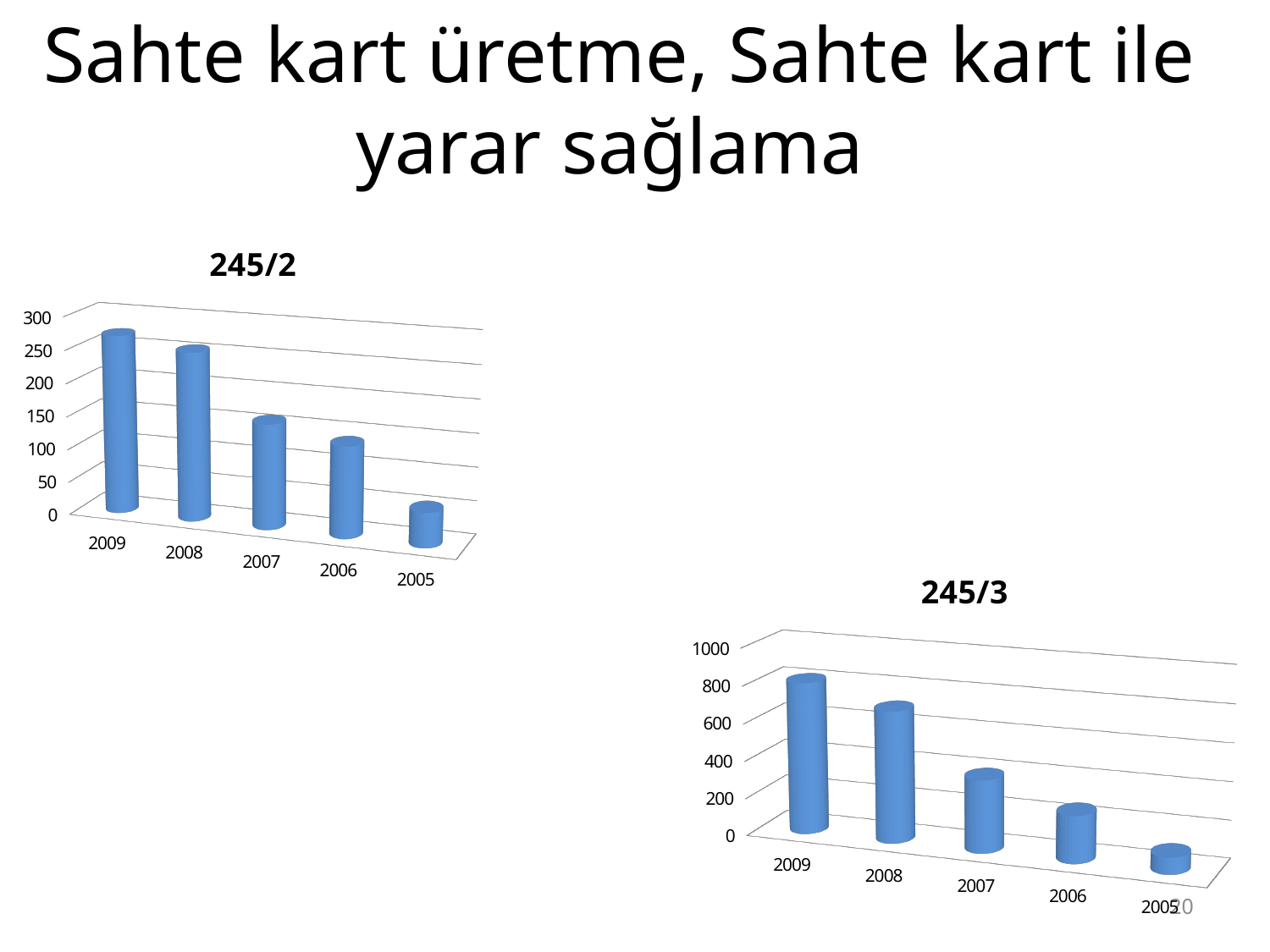
In the chart titled 245/3, which year has the lowest value? 2005 In the chart titled 245/3, is the value for 2009 greater or less than 600? greater How many years are shown on the x axis of the chart titled 245/3? 5 In the chart titled 245/2, which year has the lowest value? 2005 In the chart titled 245/2, do the values rise or fall going from 2009 to 2005 along the x axis? fall In the chart titled 245/2, is the value for 2005 greater or less than 100? less In the chart titled 245/2, which year has the highest value? 2009 In the chart titled 245/3, which year has the highest value? 2009 In the chart titled 245/2, is the value for 2009 greater or less than 200? greater What kind of chart is the chart titled 245/2? bar chart In the chart titled 245/3, which is larger, the value for 2008 or the value for 2006? 2008